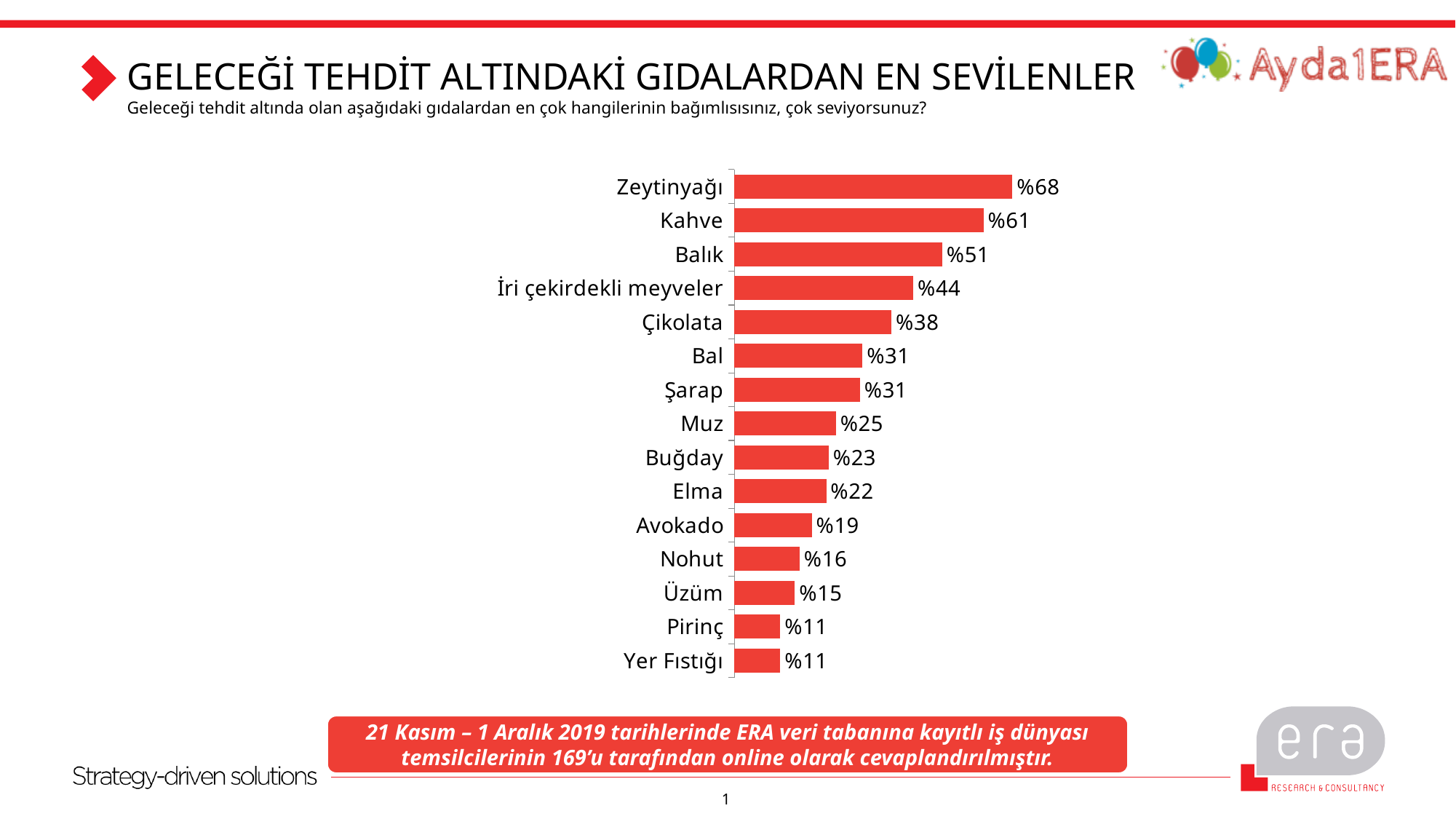
What kind of chart is shown on the slide? Bar chart Which is larger, the value for Nohut or the value for Elma? Elma What is the difference between the values for Kahve and Balık? 10 What is the value for Zeytinyağı? %68 What is the value for Avokado? %19 How many categories are shown in the chart? 15 What colour are the bars in the chart? Red What is the difference between the values for Zeytinyağı and Muz? 43 What is the value for Şarap? %31 Which is larger, the value for İri çekirdekli meyveler or the value for Buğday? İri çekirdekli meyveler What is the value for Çikolata? %38 Which category has the highest value? Zeytinyağı